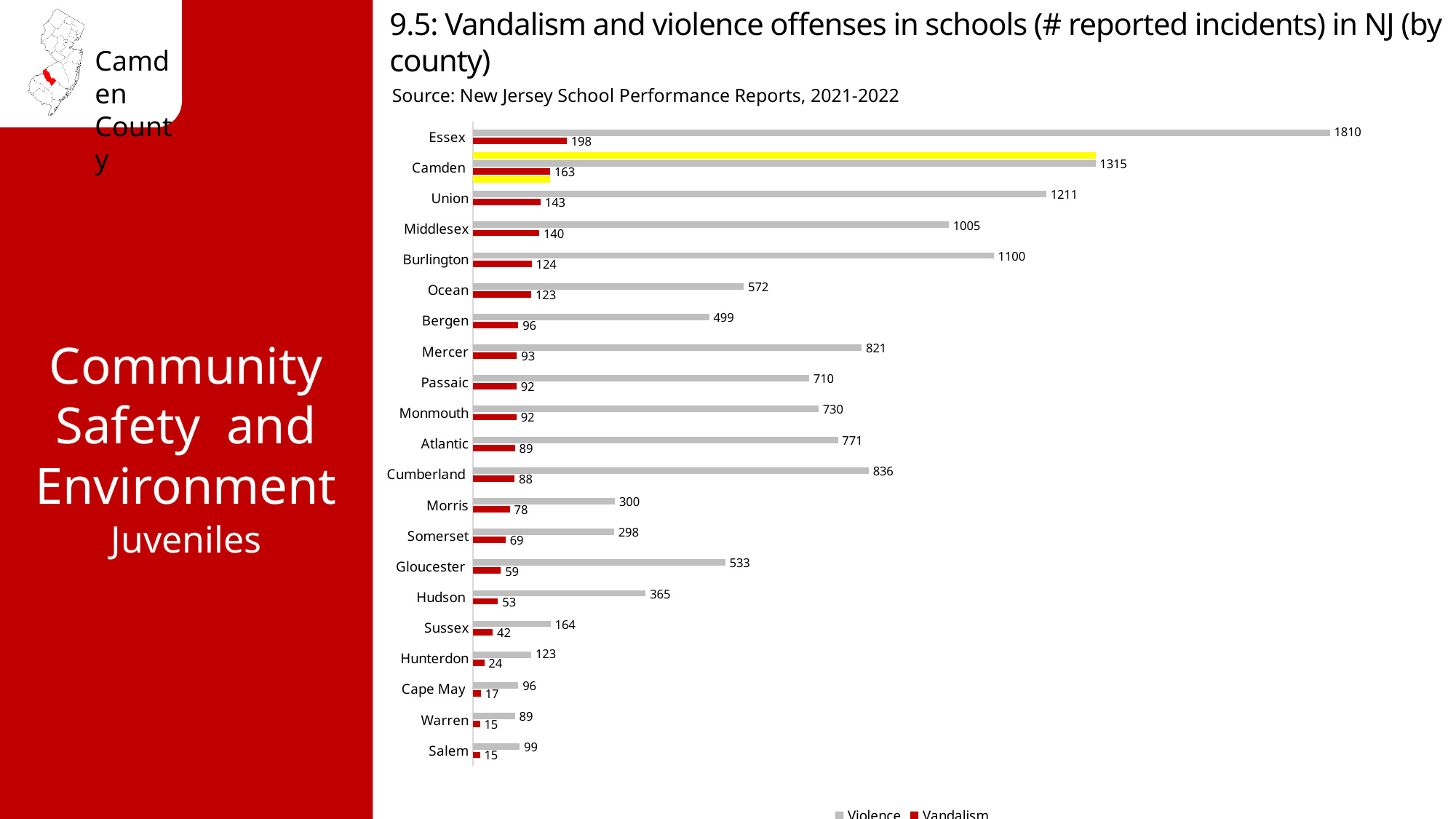
What is the number of reported violence incidents for Gloucester? 533 What is the difference between the violence incidents for Essex and Camden? 495 Which county has more reported violence incidents, Burlington or Middlesex? Burlington What type of chart is shown on the slide? bar chart What is the number of reported violence incidents for Camden? 1315 How many series does the legend list? 2 Which county has the lowest number of reported violence incidents? Warren Which county has more reported vandalism incidents, Hudson or Sussex? Hudson Which series is shown in red in the chart? Vandalism How many counties are shown in the chart? 21 Which county has the highest number of reported violence incidents? Essex What is the number of reported vandalism incidents for Essex? 198